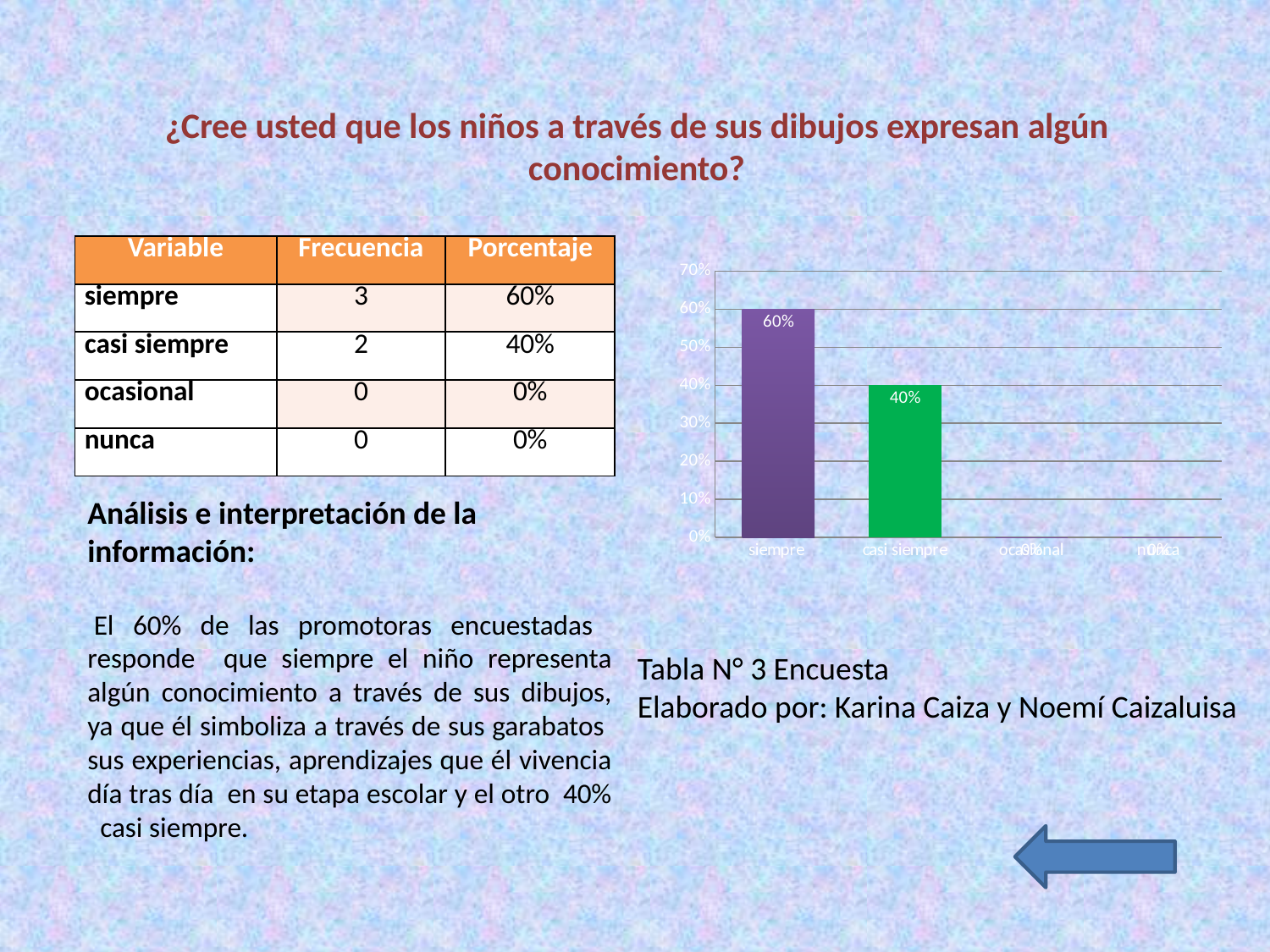
Do the values rise or fall from siempre to nunca along the x axis? fall What is the value for casi siempre in the chart? 40% Is the value for casi siempre greater or less than 50%? less Which is larger, the value for siempre or the value for casi siempre? siempre What is the value for ocasional in the chart? 0% How many categories are shown on the x axis of the chart? 4 Which category has the highest value in the chart? siempre What colour is the bar for siempre? purple What is the difference between the values for siempre and casi siempre? 20% What is the value for siempre in the chart? 60% What kind of chart is shown on the slide? bar chart What is the highest value shown on the chart's y axis? 70%